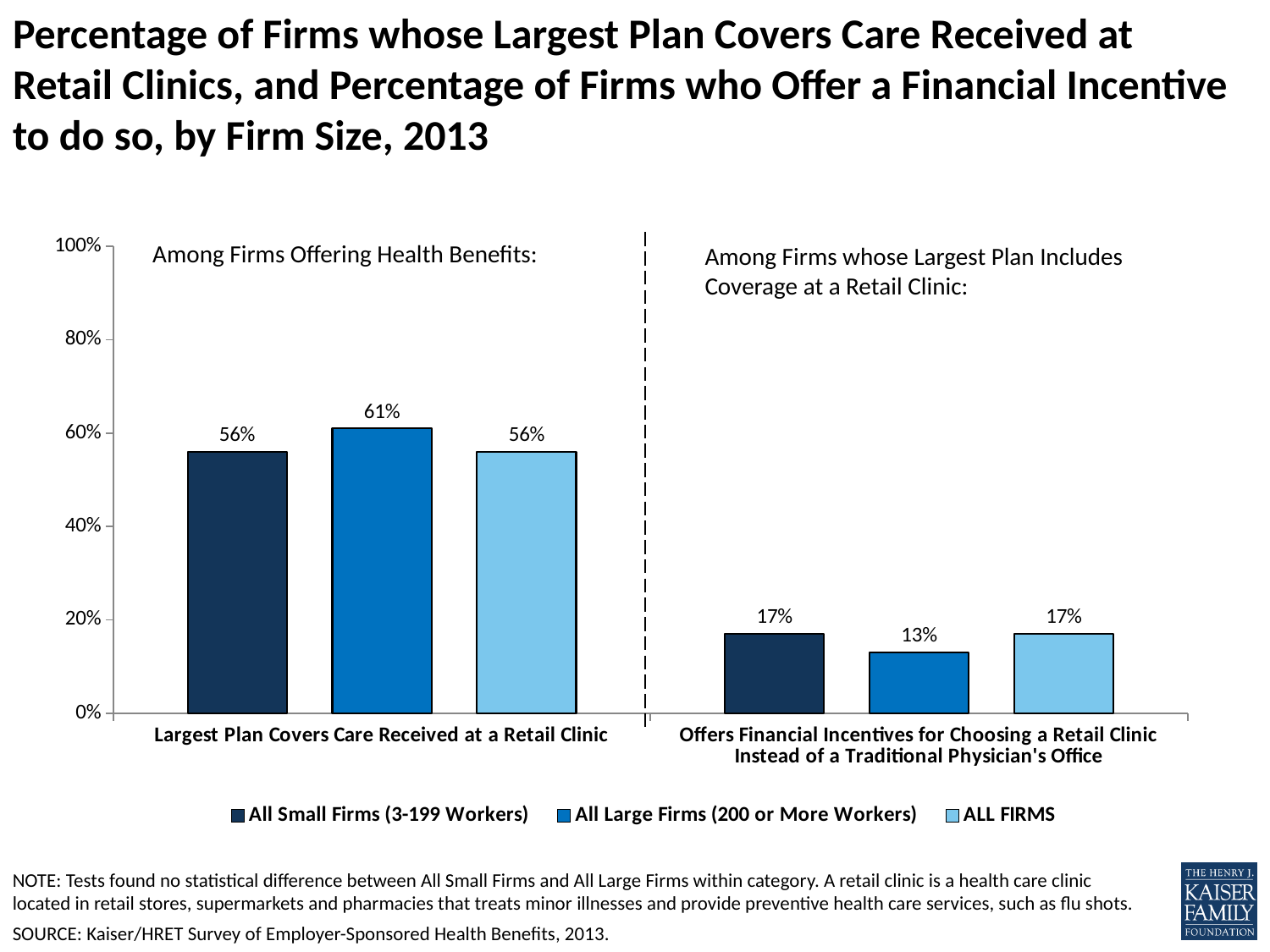
What percentage of All Small Firms (3-199 Workers) offer financial incentives for choosing a retail clinic instead of a traditional physician's office? 17% Is the value for All Small Firms in the 'Largest Plan Covers Care Received at a Retail Clinic' category larger or smaller than the value for All Small Firms in the 'Offers Financial Incentives' category? larger What kind of chart is shown on the slide? bar chart What is the difference between the All Small Firms and All Large Firms values in the 'Offers Financial Incentives' category? 4 percentage points What is the difference between the All Large Firms and All Small Firms values in the 'Largest Plan Covers Care Received at a Retail Clinic' category? 5 percentage points Which series has the highest value in the 'Largest Plan Covers Care Received at a Retail Clinic' category? All Large Firms (200 or More Workers) What is the source cited for the chart? Kaiser/HRET Survey of Employer-Sponsored Health Benefits, 2013 How many series does the legend list? 3 What is the value for ALL FIRMS in the 'Largest Plan Covers Care Received at a Retail Clinic' category? 56% What percentage of All Large Firms (200 or More Workers) have a largest plan that covers care received at a retail clinic? 61% Which series has the lowest value in the 'Offers Financial Incentives for Choosing a Retail Clinic' category? All Large Firms (200 or More Workers) What is the value for All Large Firms (200 or More Workers) in the 'Offers Financial Incentives' category? 13%